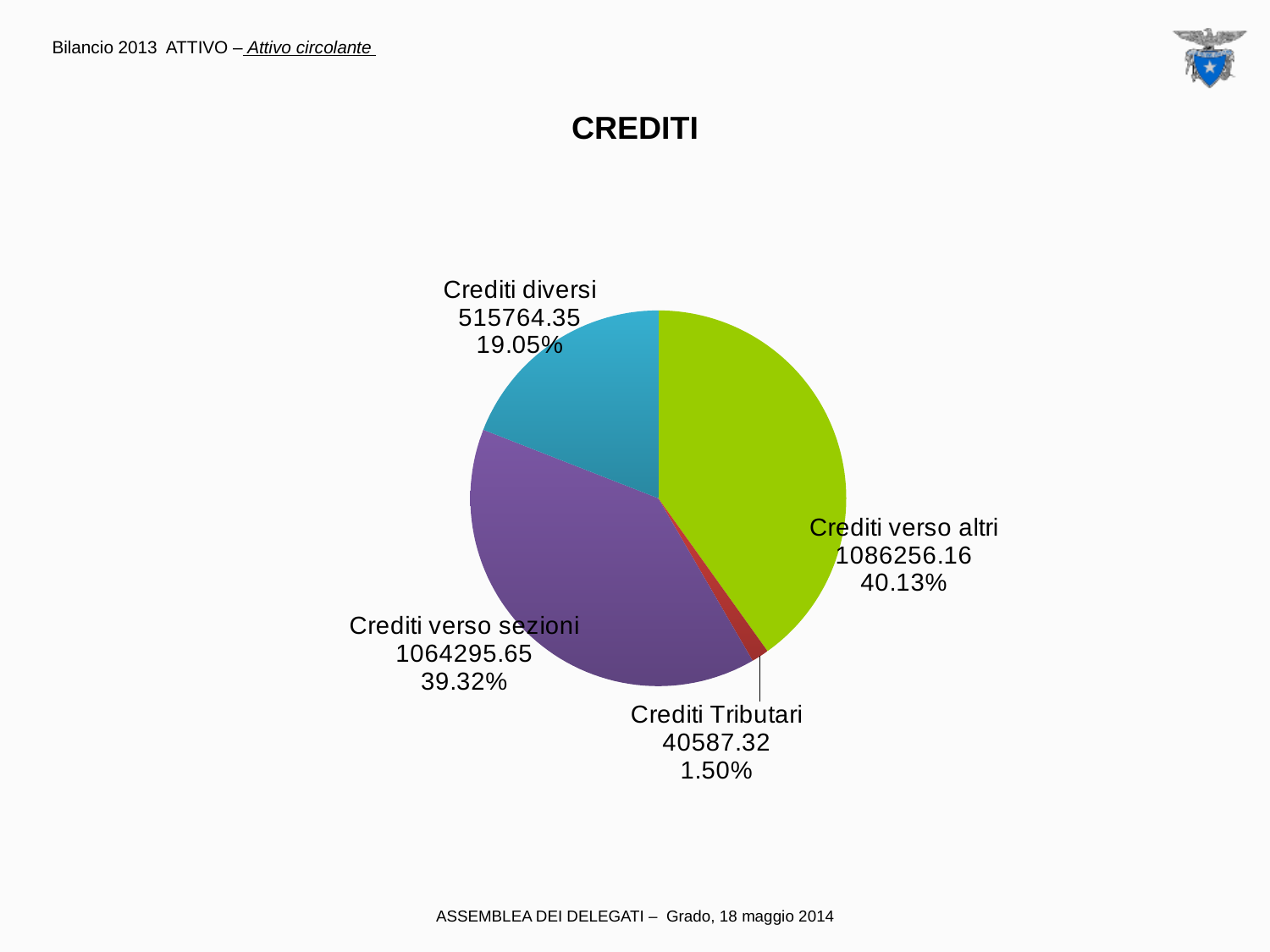
What percentage share of the pie is Crediti diversi? 19.05% What is the value shown for Crediti verso altri? 1086256.16 What is the value shown for Crediti verso sezioni? 1064295.65 What type of chart is shown on the slide? pie chart Which is larger, the value for Crediti diversi or the value for Crediti Tributari? Crediti diversi What percentage share of the pie is Crediti verso altri? 40.13% How many slices does the pie chart have? 4 What is the value shown for Crediti Tributari? 40587.32 What is the title of the chart? CREDITI Which category has the largest slice of the pie? Crediti verso altri Which category has the smallest slice of the pie? Crediti Tributari What is the difference between the values for Crediti diversi and Crediti Tributari? 475177.03